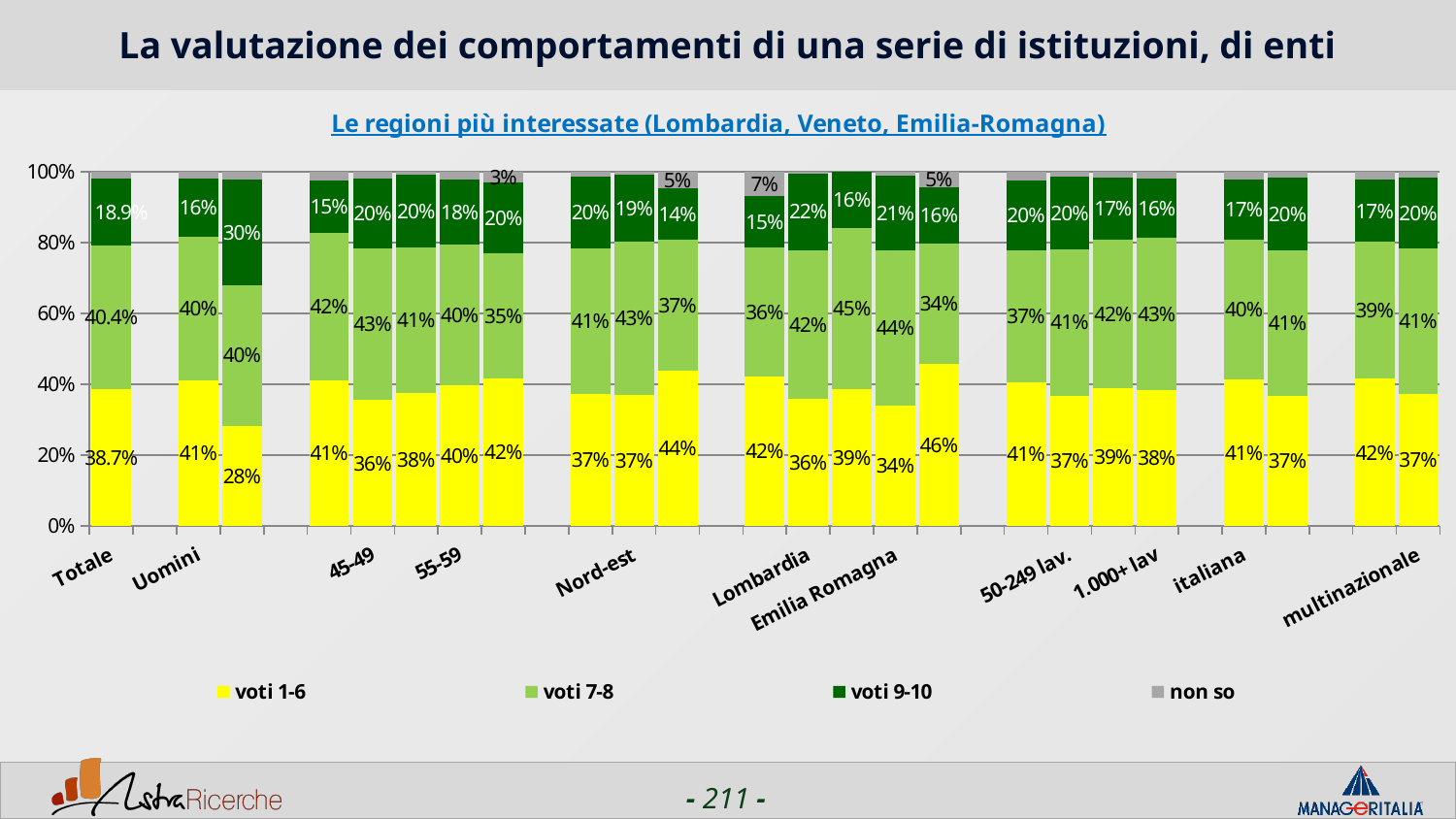
What is the 'voti 9-10' value for Totale? 18.9% What are the legend entries of the chart? voti 1-6, voti 7-8, voti 9-10, non so What is the 'voti 7-8' value for Emilia Romagna? 44% For Totale, what is the difference between the 'voti 7-8' value and the 'voti 1-6' value? 1.7 percentage points What is the 'voti 9-10' value for Lombardia? 22% What percentage of the Totale bar is 'voti 1-6'? 38.7% What is the 'voti 9-10' value for 1.000+ lav? 16% How many series does the legend list? 4 What is the 'voti 1-6' value for Nord-est? 37% Which has the larger 'voti 1-6' value, Lombardia or Emilia Romagna? Lombardia What is the 'voti 7-8' value for Uomini? 40% What kind of chart is shown on the slide? Stacked bar chart